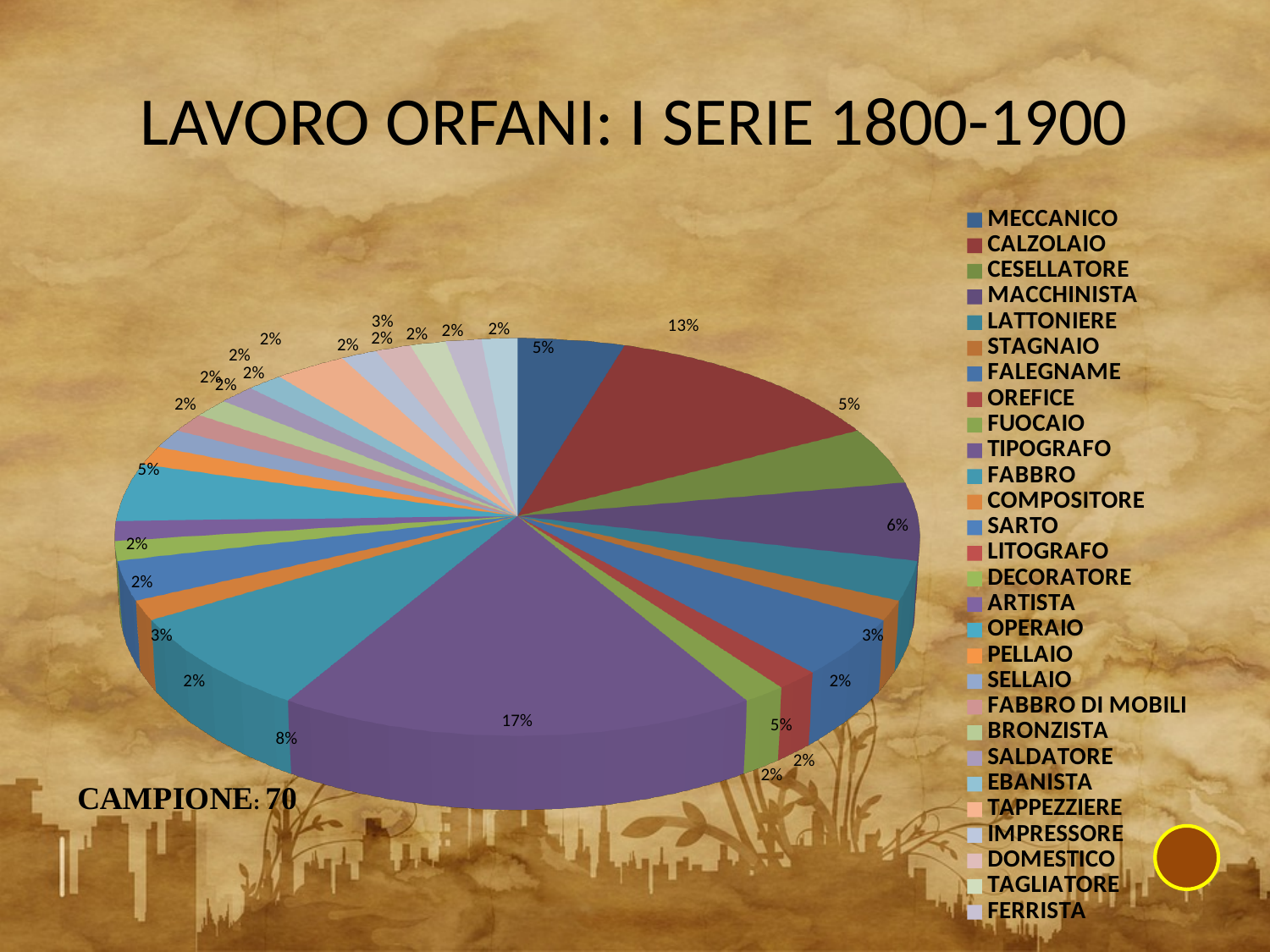
What percentage share does MACCHINISTA have? 6% What percentage share does FABBRO have? 8% What percentage share does TIPOGRAFO have? 17% What sample size (CAMPIONE) is stated on the slide? 70 Which category has the largest slice of the pie? TIPOGRAFO Which is larger, the share for CALZOLAIO or the share for MACCHINISTA? CALZOLAIO How many categories does the legend list? 28 What kind of chart is shown on the slide? Pie chart What is the difference in percentage points between CALZOLAIO and MECCANICO? 8 What is the title of the chart? LAVORO ORFANI: I SERIE 1800-1900 What percentage share does MECCANICO have? 5% What percentage share does CALZOLAIO have? 13%